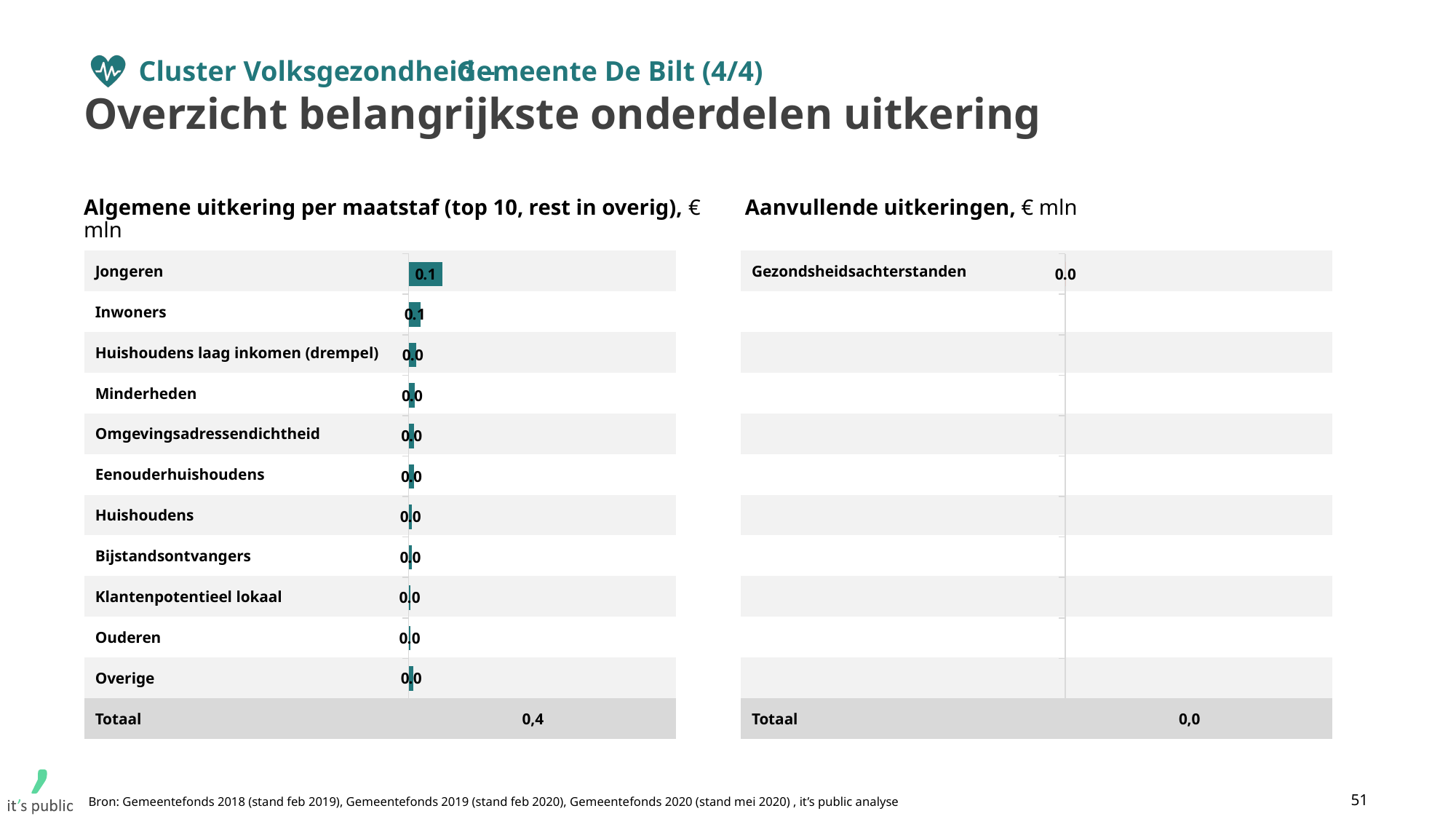
In the chart 'Algemene uitkering per maatstaf (top 10, rest in overig)', which is larger: the bar for Jongeren or the bar for Huishoudens? Jongeren In the chart 'Aanvullende uitkeringen', how many categories are shown (excluding the Totaal row)? 1 In the chart 'Algemene uitkering per maatstaf (top 10, rest in overig)', what is the Totaal value shown? 0,4 What kind of chart is 'Algemene uitkering per maatstaf (top 10, rest in overig)'? Bar chart In the chart 'Algemene uitkering per maatstaf (top 10, rest in overig)', what is the value for Overige? 0.0 In the chart 'Algemene uitkering per maatstaf (top 10, rest in overig)', how many categories are shown (excluding the Totaal row)? 11 In the chart 'Algemene uitkering per maatstaf (top 10, rest in overig)', what is the value for Inwoners? 0.1 In the chart 'Algemene uitkering per maatstaf (top 10, rest in overig)', what is the value for Minderheden? 0.0 In the chart 'Algemene uitkering per maatstaf (top 10, rest in overig)', which category has the longest bar? Jongeren In the chart 'Aanvullende uitkeringen', what is the Totaal value shown? 0,0 In the chart 'Algemene uitkering per maatstaf (top 10, rest in overig)', what is the value for Jongeren? 0.1 In the chart 'Aanvullende uitkeringen', what is the value for Gezondsheidsachterstanden? 0.0